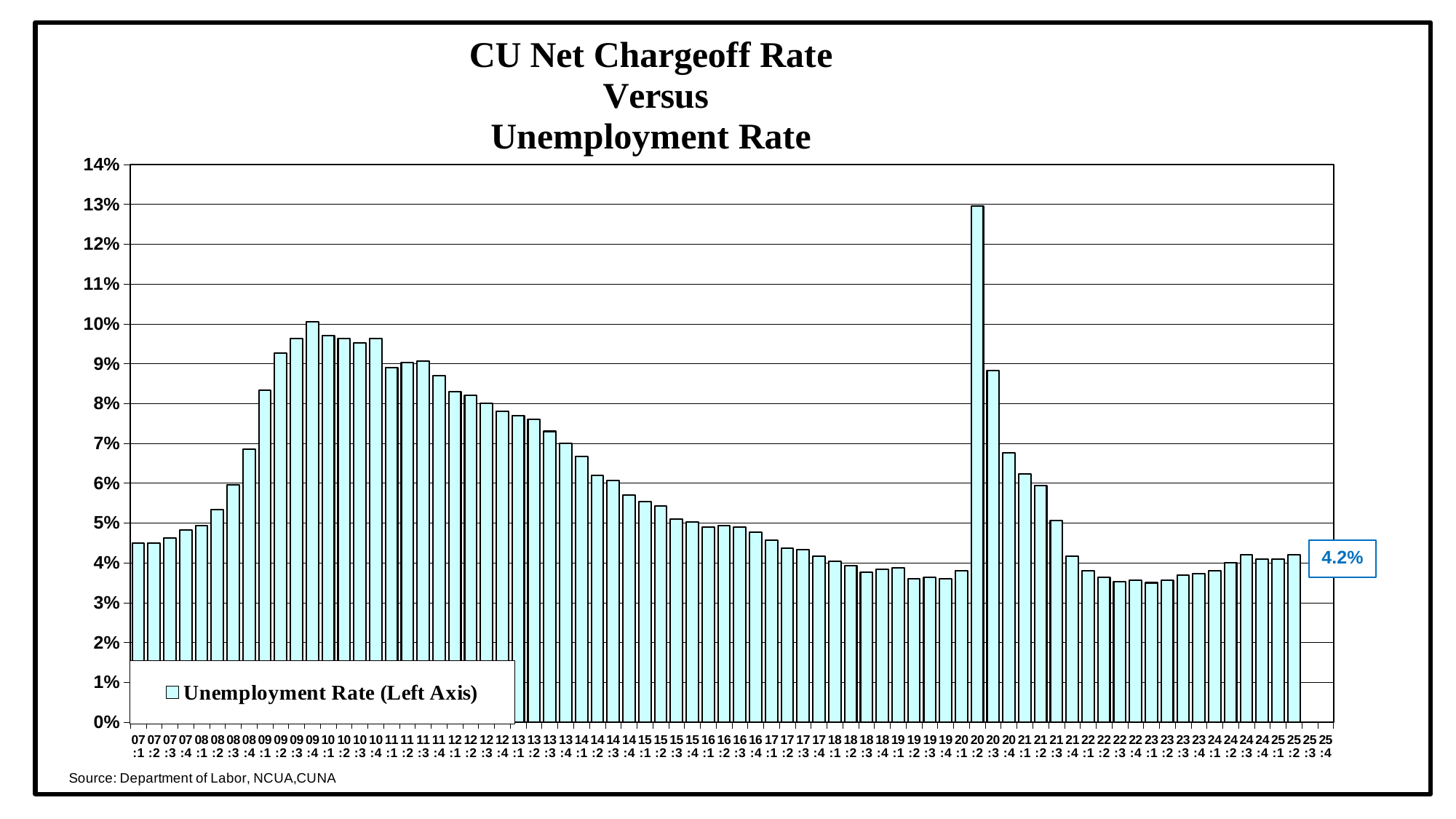
Is the unemployment rate for 20:2 greater or less than 12%? greater Do the unemployment rate values generally rise or fall from 09:4 to 19:4? fall What is the series name shown in the legend? Unemployment Rate (Left Axis) Which quarter has the highest unemployment rate in the chart? 20:2 Which has a higher unemployment rate, 09:4 or 07:1? 09:4 Is the unemployment rate for 19:2 greater or less than 4%? less What kind of chart is shown on the slide? bar chart How many series does the legend list? 1 Which has a higher unemployment rate, 20:2 or 20:3? 20:2 What is the unemployment rate value labeled on the last bar (25:2)? 4.2% Is the unemployment rate for 07:1 greater or less than 5%? less